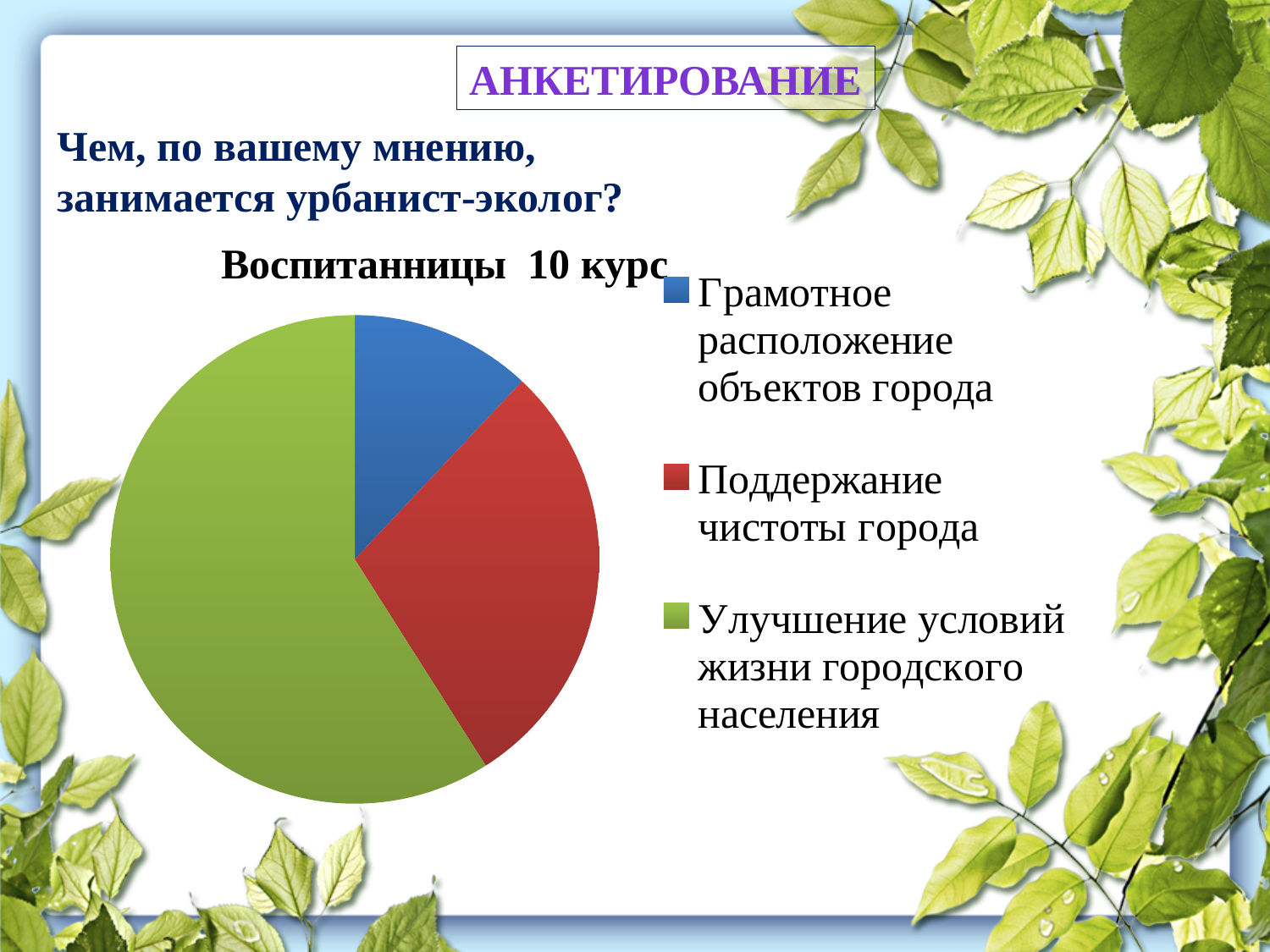
Which category has the largest slice of the pie chart? Улучшение условий жизни городского населения How many slices does the pie chart have? 3 Which slice is larger: "Поддержание чистоты города" or "Грамотное расположение объектов города"? Поддержание чистоты города Which category has the smallest slice of the pie chart? Грамотное расположение объектов города What kind of chart is shown on the slide? pie chart Which slice is larger: "Улучшение условий жизни городского населения" or "Поддержание чистоты города"? Улучшение условий жизни городского населения What colour is the slice for "Поддержание чистоты города" in the pie chart? red How many entries does the legend of the pie chart list? 3 What is the title of the pie chart? Воспитанницы 10 курс